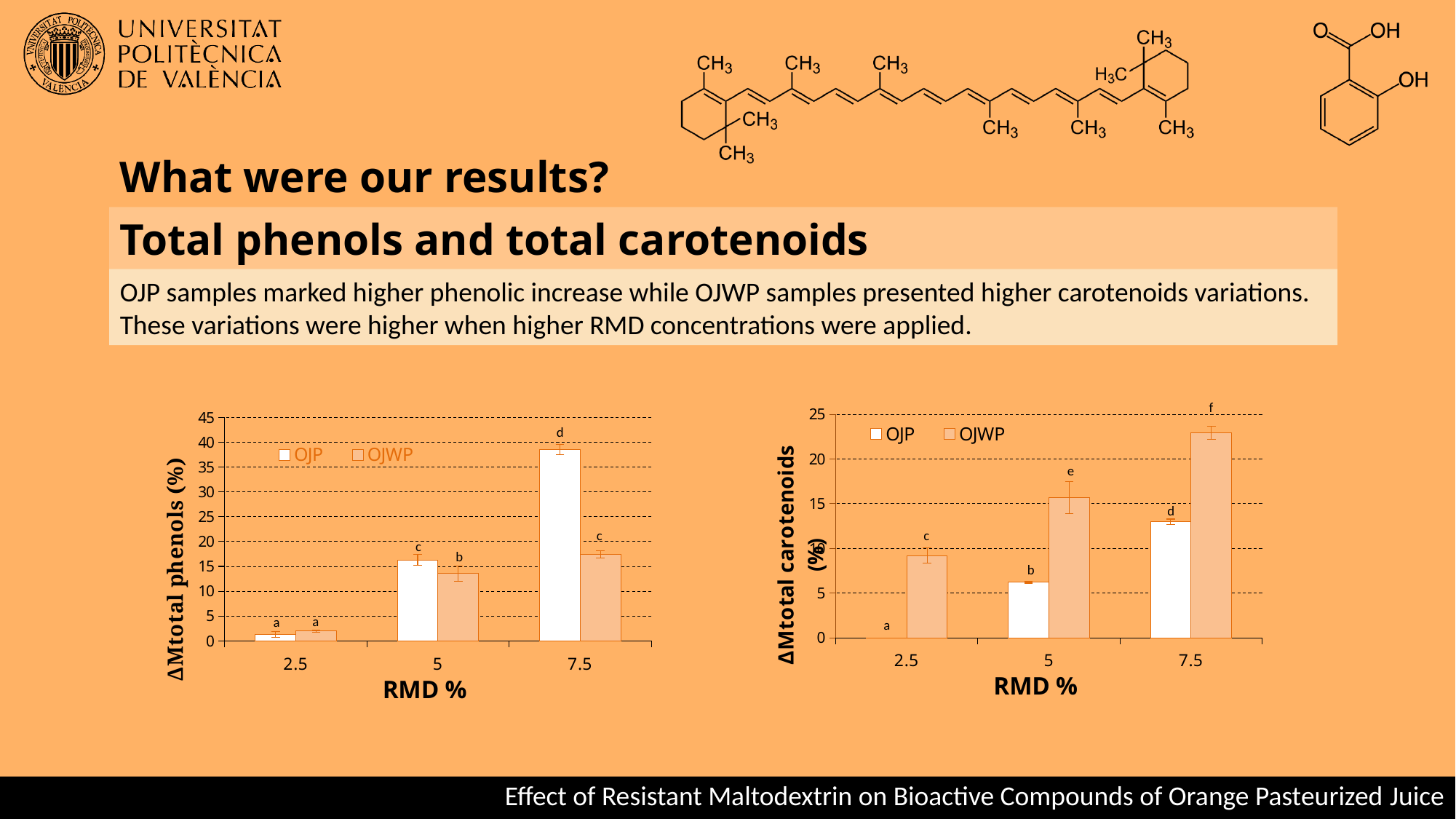
In the left chart (ΔMtotal phenols), do the OJP values rise or fall as RMD % increases? rise In the left chart (ΔMtotal phenols), how many RMD % categories are shown on the x axis? 3 In the left chart (ΔMtotal phenols), at which RMD % is the OJP value highest? 7.5 In the right chart (ΔMtotal carotenoids), at RMD 5, which series has the larger value, OJP or OJWP? OJWP In the right chart (ΔMtotal carotenoids), is the OJWP value at RMD 7.5 greater or less than 20? greater In the left chart (ΔMtotal phenols), how many series does the legend list? 2 In the left chart (ΔMtotal phenols), is the OJP value at RMD 7.5 greater or less than 35? greater In the left chart (ΔMtotal phenols), what kind of chart is shown? bar chart In the right chart (ΔMtotal carotenoids), at which RMD % is the OJWP value lowest? 2.5 In the right chart (ΔMtotal carotenoids), is the OJP value at RMD 5 greater or less than 10? less In the left chart (ΔMtotal phenols), at RMD 7.5, which series has the larger value, OJP or OJWP? OJP In the right chart, what is the label on the y axis? ΔMtotal carotenoids (%)